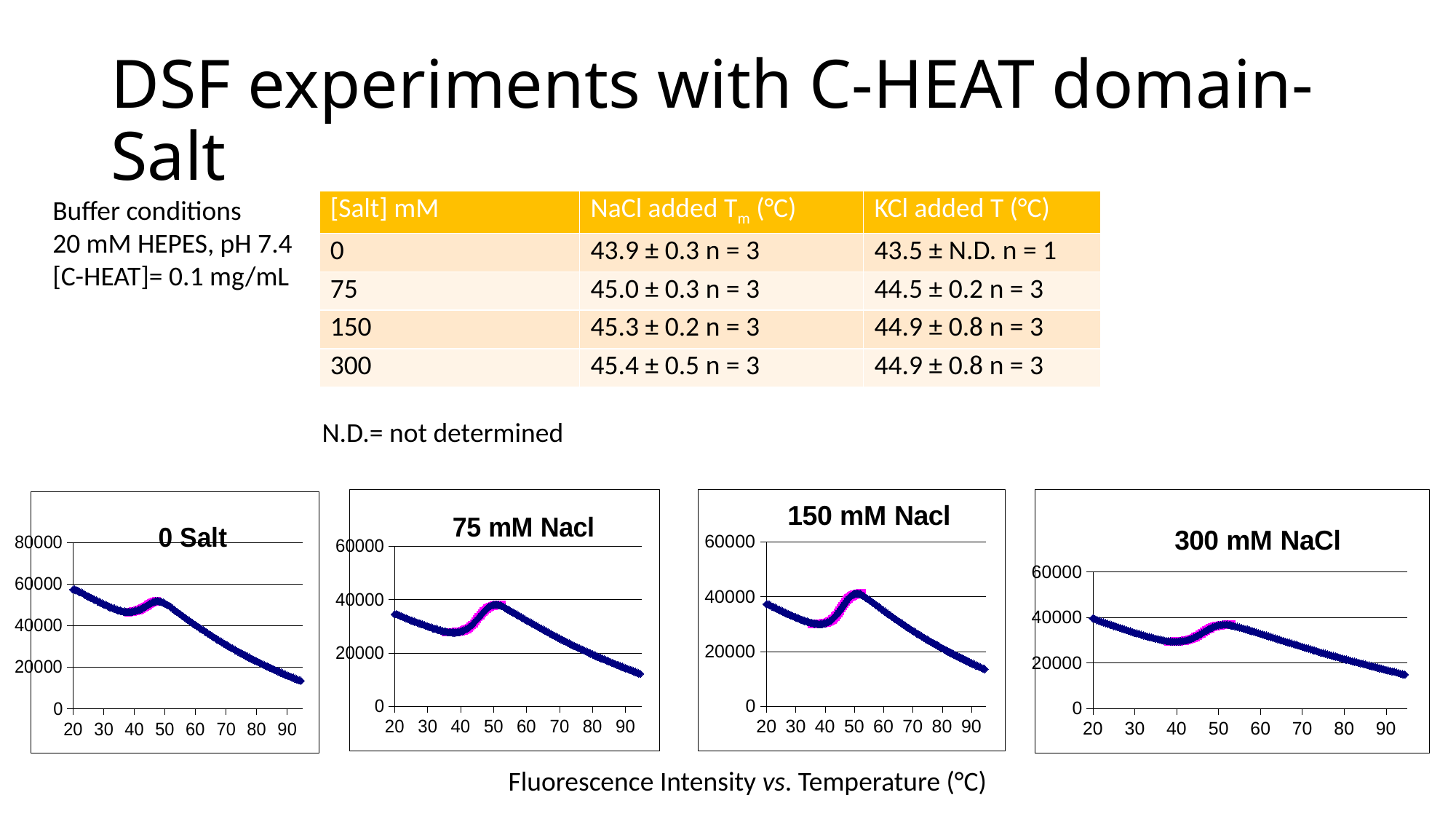
In the '150 mM NaCl' chart, is the fluorescence intensity at 20 °C greater or less than the value at 90 °C? greater How many charts are shown on the slide? 4 In the '75 mM NaCl' chart, is the fluorescence intensity at 20 °C greater or less than 40000? less In the '0 Salt' chart, is the fluorescence intensity at 90 °C greater or less than 20000? less In the '0 Salt' chart, what is the highest value shown on the y axis? 80000 What is the title of the rightmost chart? 300 mM NaCl In the '150 mM NaCl' chart, is the fluorescence intensity at 90 °C greater or less than 20000? less In the '75 mM NaCl' chart, what is the highest value shown on the y axis? 60000 In the '300 mM NaCl' chart, does the fluorescence intensity overall rise or fall from 20 °C to 90 °C? fall What is the title of the leftmost chart? 0 Salt What kind of chart is the '0 Salt' chart? scatter chart